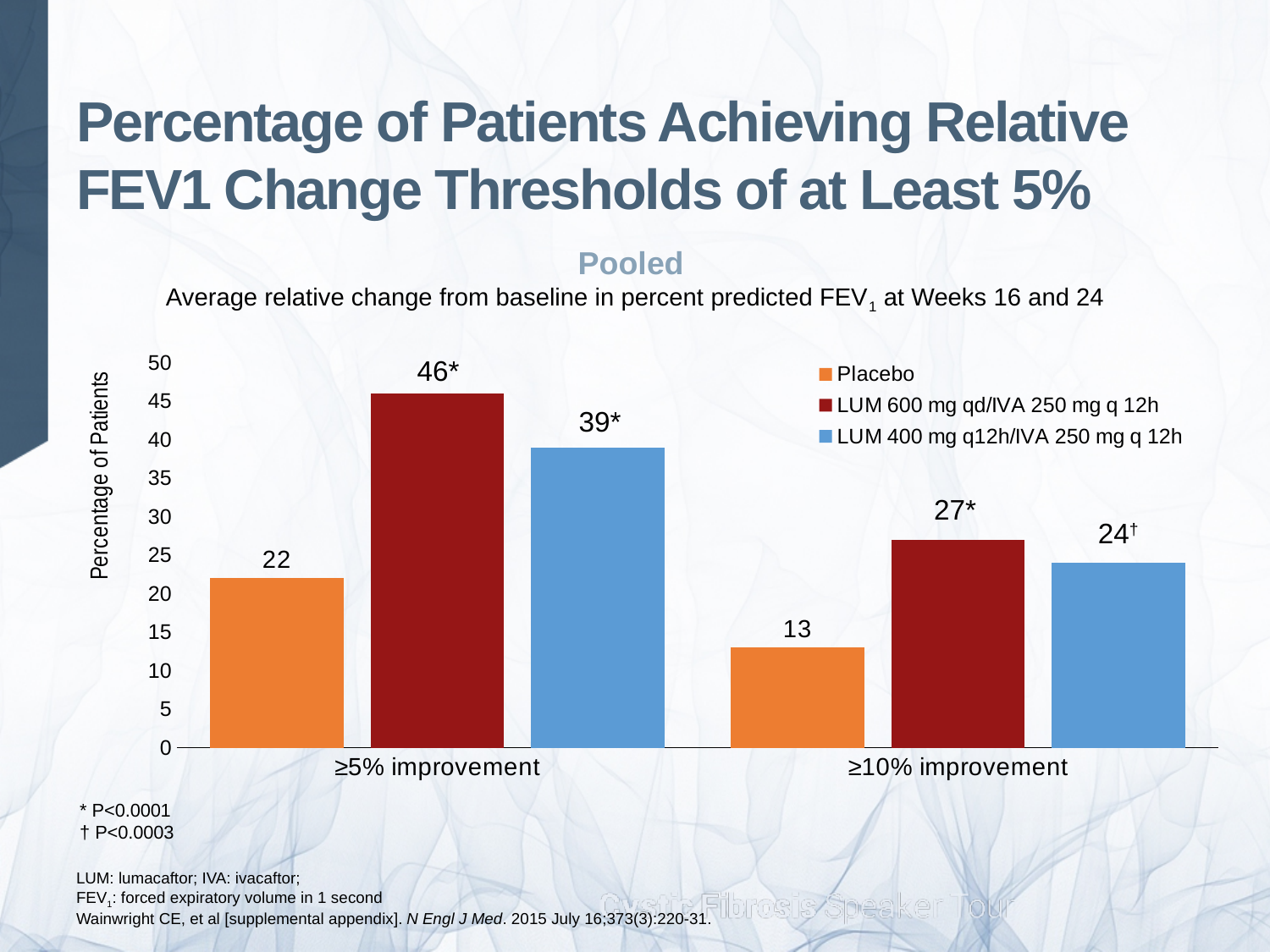
Which series has the highest value in the ≥5% improvement category? LUM 600 mg qd/IVA 250 mg q 12h How many categories are shown on the x axis? 2 What is the value for Placebo in the ≥5% improvement category? 22 Which series has the lowest value in the ≥10% improvement category? Placebo How many series does the legend list? 3 What is the difference between the Placebo values for ≥5% improvement and ≥10% improvement? 9 What is the value for LUM 600 mg qd/IVA 250 mg q 12h in the ≥10% improvement category? 27* What is the label of the y axis? Percentage of Patients What is the value for LUM 400 mg q12h/IVA 250 mg q 12h in the ≥5% improvement category? 39* Which is larger: the LUM 400 mg q12h/IVA 250 mg q 12h value for ≥5% improvement or for ≥10% improvement? ≥5% improvement What kind of chart is shown on the slide? Bar chart What is the difference between the LUM 600 mg qd/IVA 250 mg q 12h value and the Placebo value in the ≥5% improvement category? 24